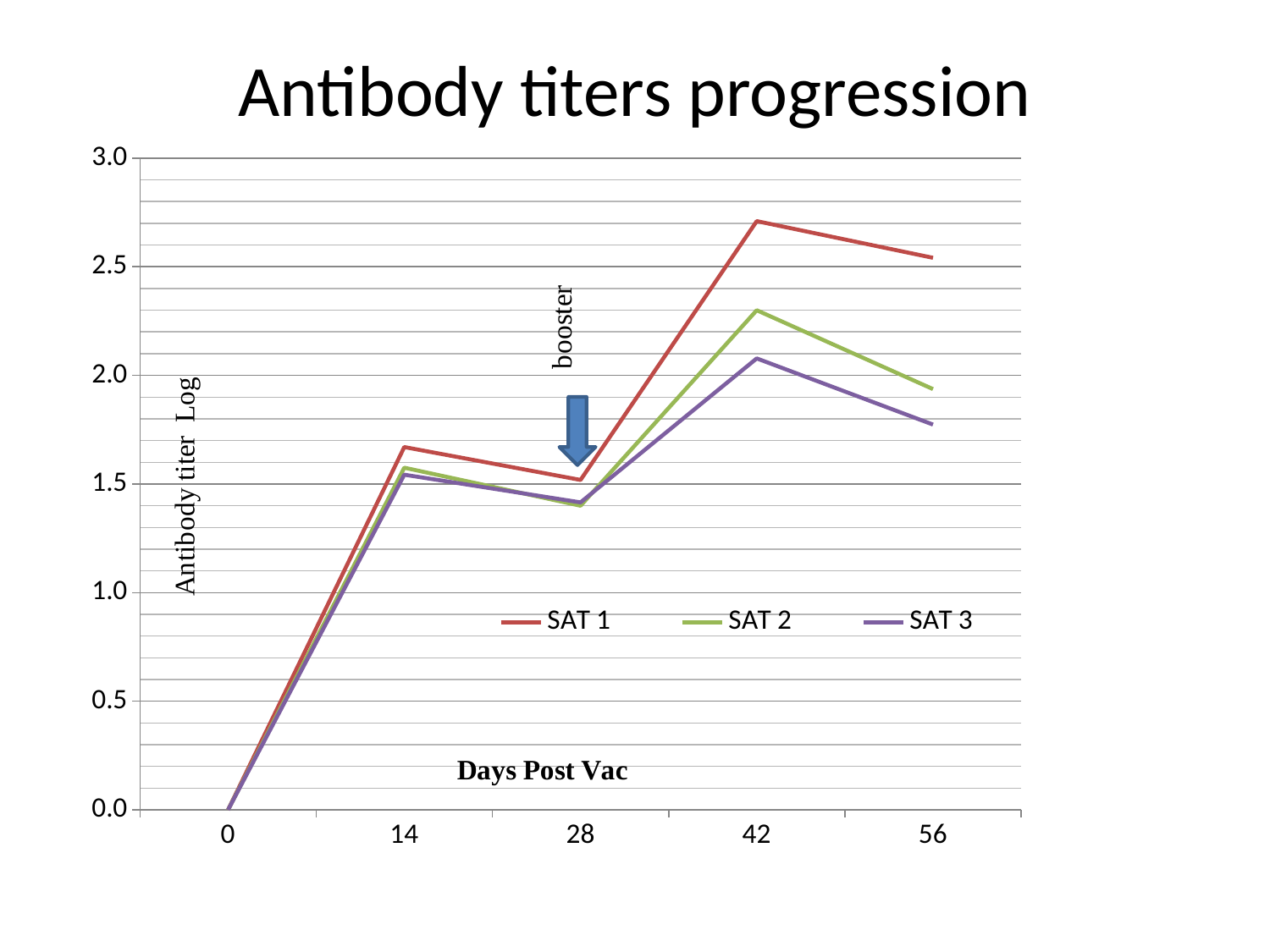
Which series has the highest value at day 42? SAT 1 At day 56, which is larger, SAT 2 or SAT 3? SAT 2 Is the value for SAT 2 at day 42 greater or less than 2.5? less Does SAT 1 rise or fall between day 42 and day 56? fall Is the value for SAT 1 at day 42 greater or less than 2.5? greater What kind of chart is shown on the slide? line chart Is the value for SAT 3 at day 56 greater or less than 2.0? less How many time points are plotted along the x axis? 5 Which series has the lowest value at day 56? SAT 3 What is the label on the x axis of the chart? Days Post Vac What is the value of SAT 1 at day 0? 0.0 How many series does the legend list? 3